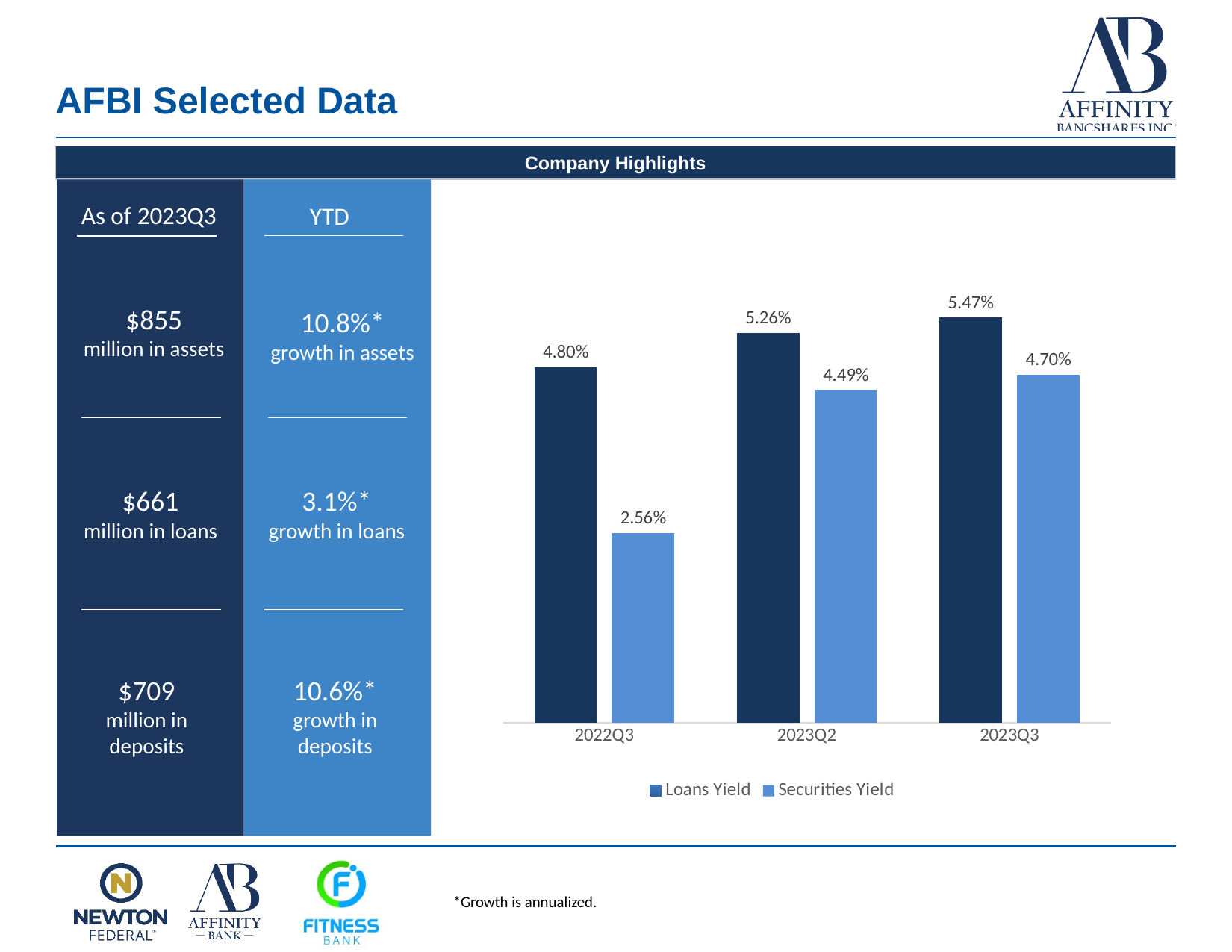
What is the Securities Yield for 2022Q3? 2.56% How many quarters are shown on the x axis of the chart? 3 How many series does the chart legend list? 2 Which quarter has the lowest Securities Yield? 2022Q3 What is the Loans Yield for 2022Q3? 4.80% What kind of chart is shown on the slide? Bar chart What is the difference between the Loans Yield and the Securities Yield in 2022Q3? 2.24% What is the Loans Yield for 2023Q3? 5.47% Which quarter has the highest Loans Yield? 2023Q3 By how much did the Securities Yield increase from 2022Q3 to 2023Q3? 2.14% What is the Securities Yield for 2023Q2? 4.49% Which is larger, the Loans Yield in 2023Q2 or the Securities Yield in 2023Q3? Loans Yield in 2023Q2